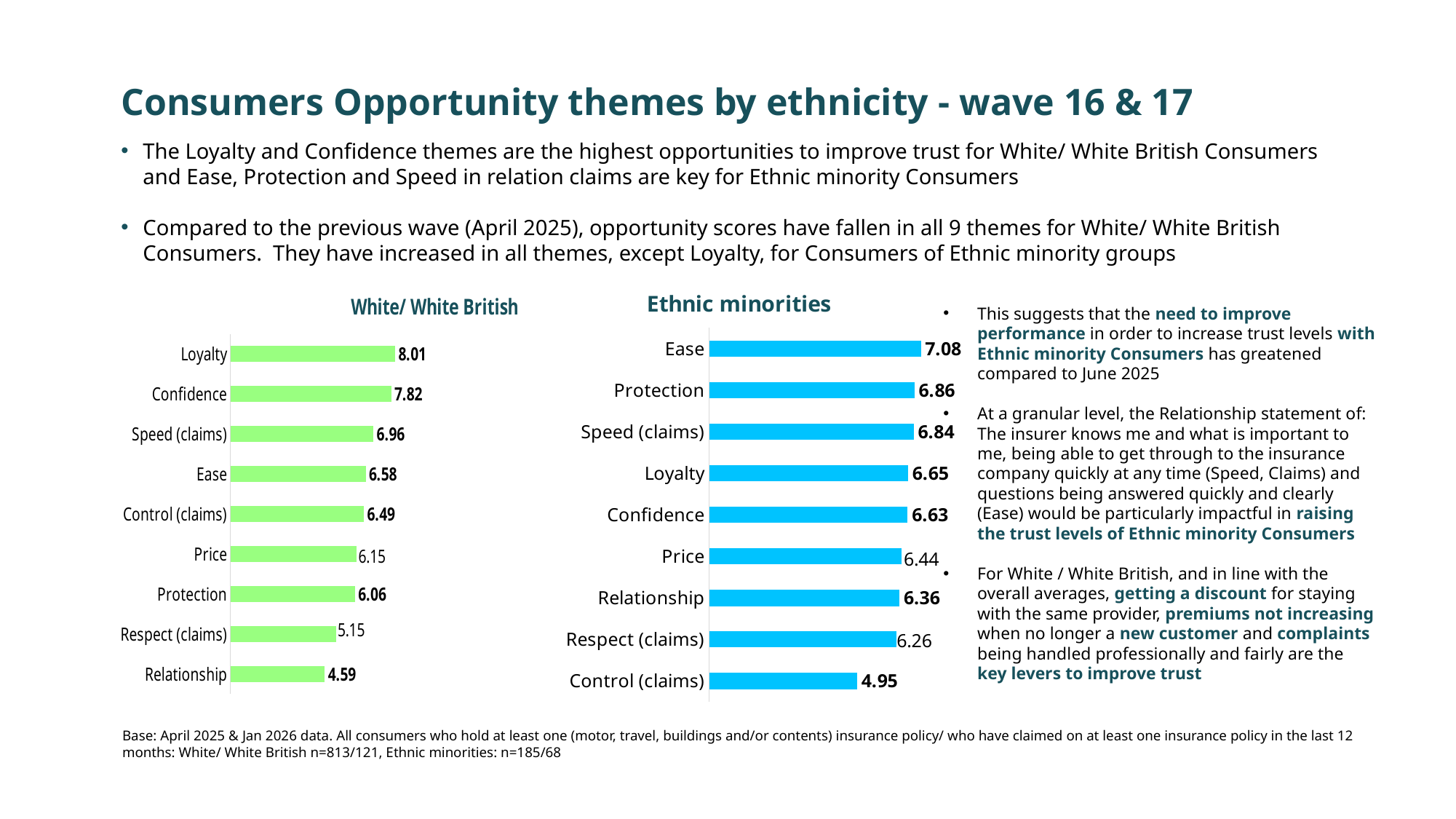
In the White/ White British chart, what is the value for Respect (claims)? 5.15 In the Ethnic minorities chart, what is the value for Speed (claims)? 6.84 In the White/ White British chart, what is the difference between Loyalty and Confidence? 0.19 In the White/ White British chart, which theme has the lowest value? Relationship Which is larger: the Protection value in the White/ White British chart or the Protection value in the Ethnic minorities chart? Ethnic minorities What colour are the bars in the Ethnic minorities chart? Blue In the White/ White British chart, what is the value for Loyalty? 8.01 In the Ethnic minorities chart, what is the difference between Ease and Control (claims)? 2.13 In the Ethnic minorities chart, which theme has the lowest value? Control (claims) How many themes are shown in the White/ White British chart? 9 In the Ethnic minorities chart, which theme has the highest value? Ease What type of chart is the Ethnic minorities chart? Bar chart